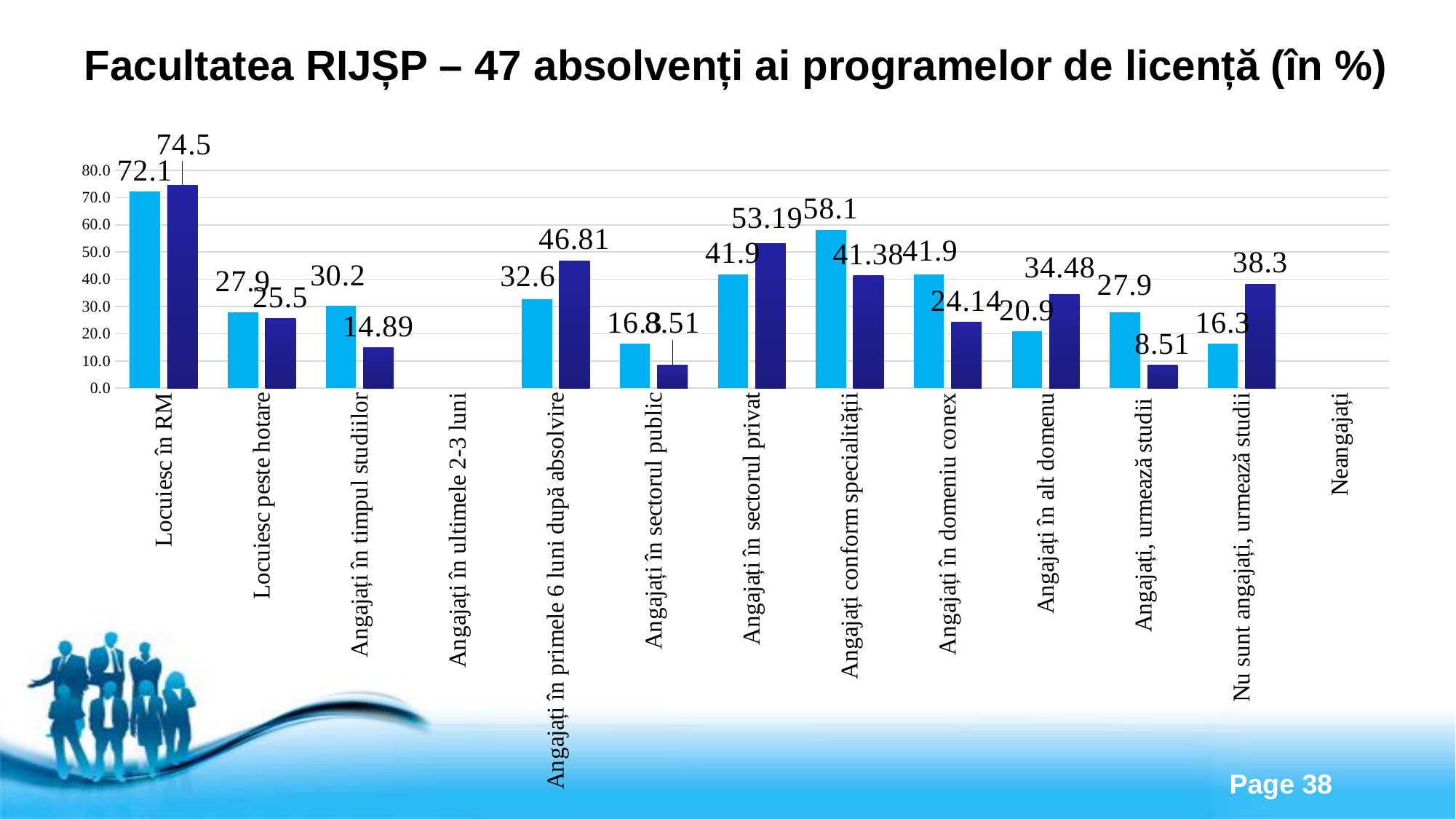
Which category has the highest dark blue bar? Locuiesc în RM What is the difference between the light blue and dark blue bars for "Angajați conform specialității"? 16.72 What is the difference between the dark blue and light blue bars for "Locuiesc în RM"? 2.4 What is the value of the dark blue bar for "Nu sunt angajați, urmează studii"? 38.3 What is the value of the light blue bar for "Angajați conform specialității"? 58.1 Is the value of the dark blue bar for "Angajați în alt domenu" greater or less than 30.0? greater What type of chart is shown on the slide? bar chart How many categories are labelled on the x axis of the chart? 13 For "Angajați în primele 6 luni după absolvire", which bar is larger, the light blue or the dark blue? dark blue What is the value of the dark blue bar for "Angajați în sectorul privat"? 53.19 What is the value of the light blue bar for "Locuiesc în RM"? 72.1 Which category has the highest light blue bar? Locuiesc în RM